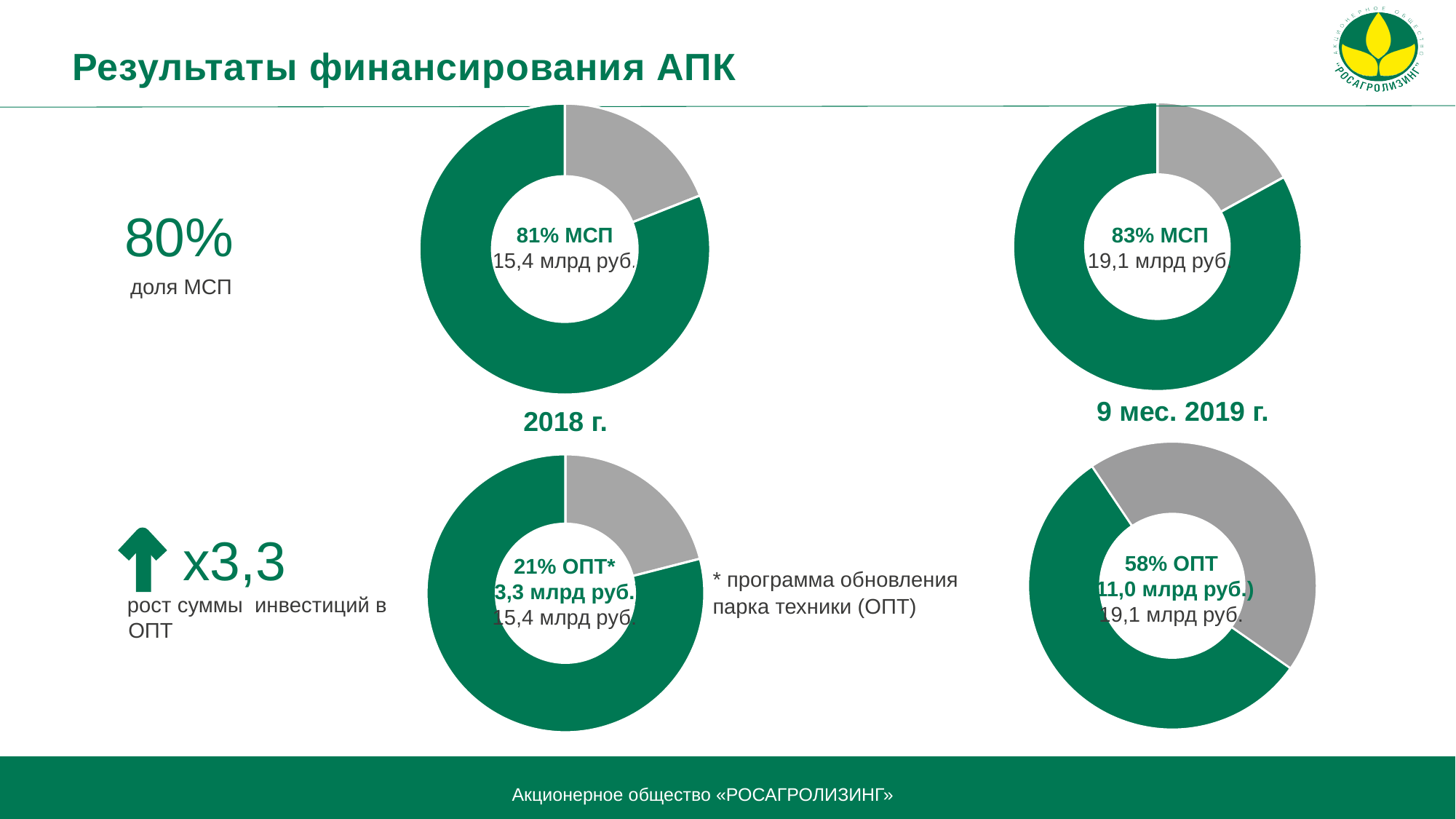
How many donut charts are on the slide? 4 In the top-right chart (9 мес. 2019 г.), what share is labelled for МСП? 83% In the top-right chart (9 мес. 2019 г.), what amount in млрд руб. is printed in the centre? 19,1 млрд руб. In the top-left chart (2018 г.), what share is labelled for МСП? 81% In the bottom-left chart (2018 г.), what share is labelled for ОПТ? 21% By how many percentage points does the ОПТ share in the bottom-right chart (9 мес. 2019 г.) exceed the ОПТ share in the bottom-left chart (2018 г.)? 37 percentage points Which chart shows the larger МСП share: the top-left (2018 г.) or the top-right (9 мес. 2019 г.)? Top-right (9 мес. 2019 г.) What kind of charts are shown on the slide? Donut (pie) charts In the bottom-right chart (9 мес. 2019 г.), what amount in млрд руб. is given for ОПТ? 11,0 млрд руб. In the top-left chart (2018 г.), what amount in млрд руб. is printed in the centre? 15,4 млрд руб. In the bottom-left chart (2018 г.), what amount in млрд руб. is given for ОПТ? 3,3 млрд руб.